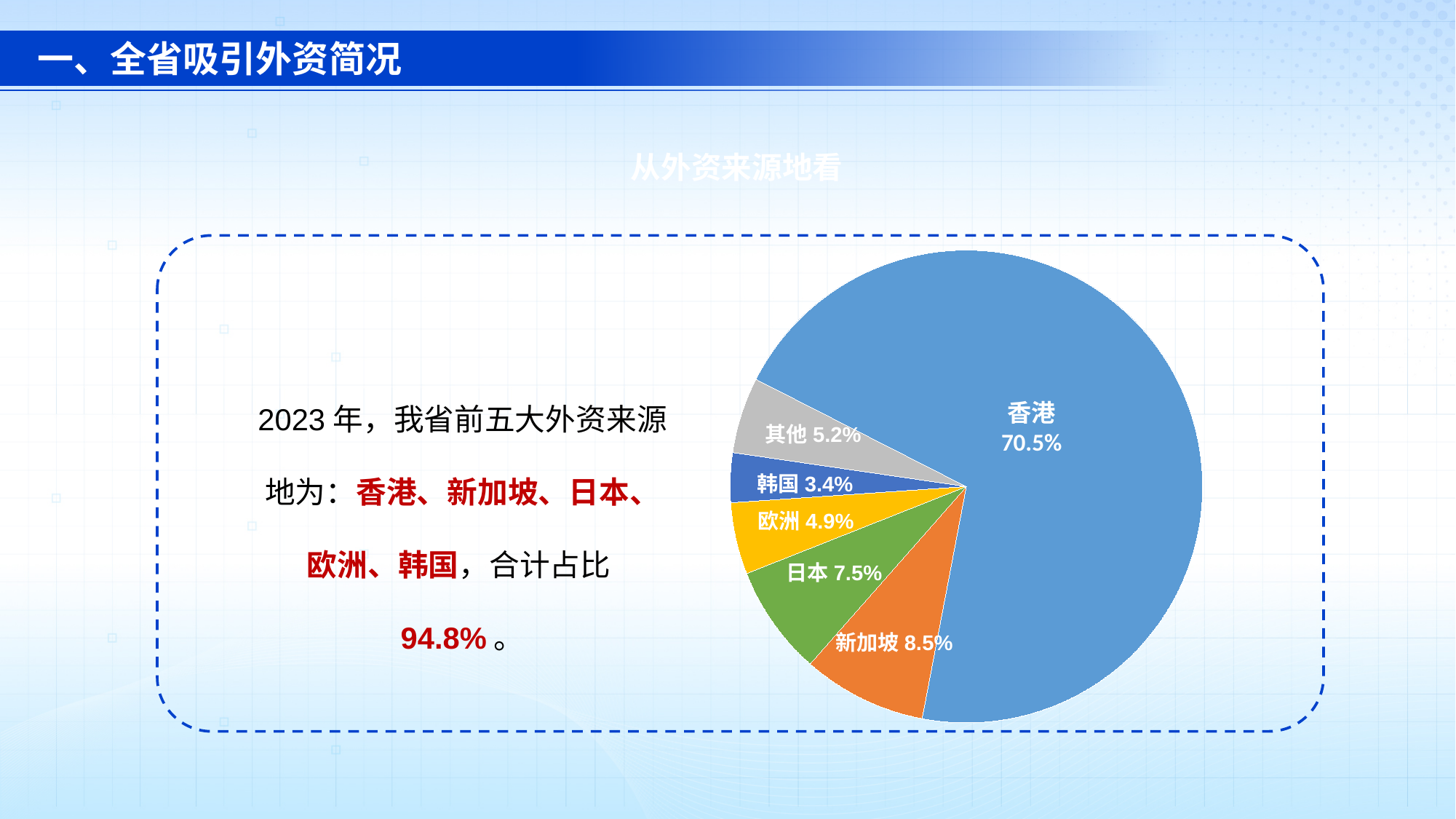
What is the value shown for 欧洲? 4.9% How many slices does the pie chart have? 6 What is the title shown above the pie chart? 从外资来源地看 What is the difference between the shares of 新加坡 and 日本? 1.0% What is the value shown for 韩国? 3.4% Which is larger, the share of 欧洲 or the share of 其他? 其他 Which slice of the pie is the largest? 香港 What is the value shown for 新加坡? 8.5% What share of the pie does 香港 account for? 70.5% What is the value shown for 日本? 7.5% What type of chart is shown on the slide? pie chart Which slice of the pie is the smallest? 韩国